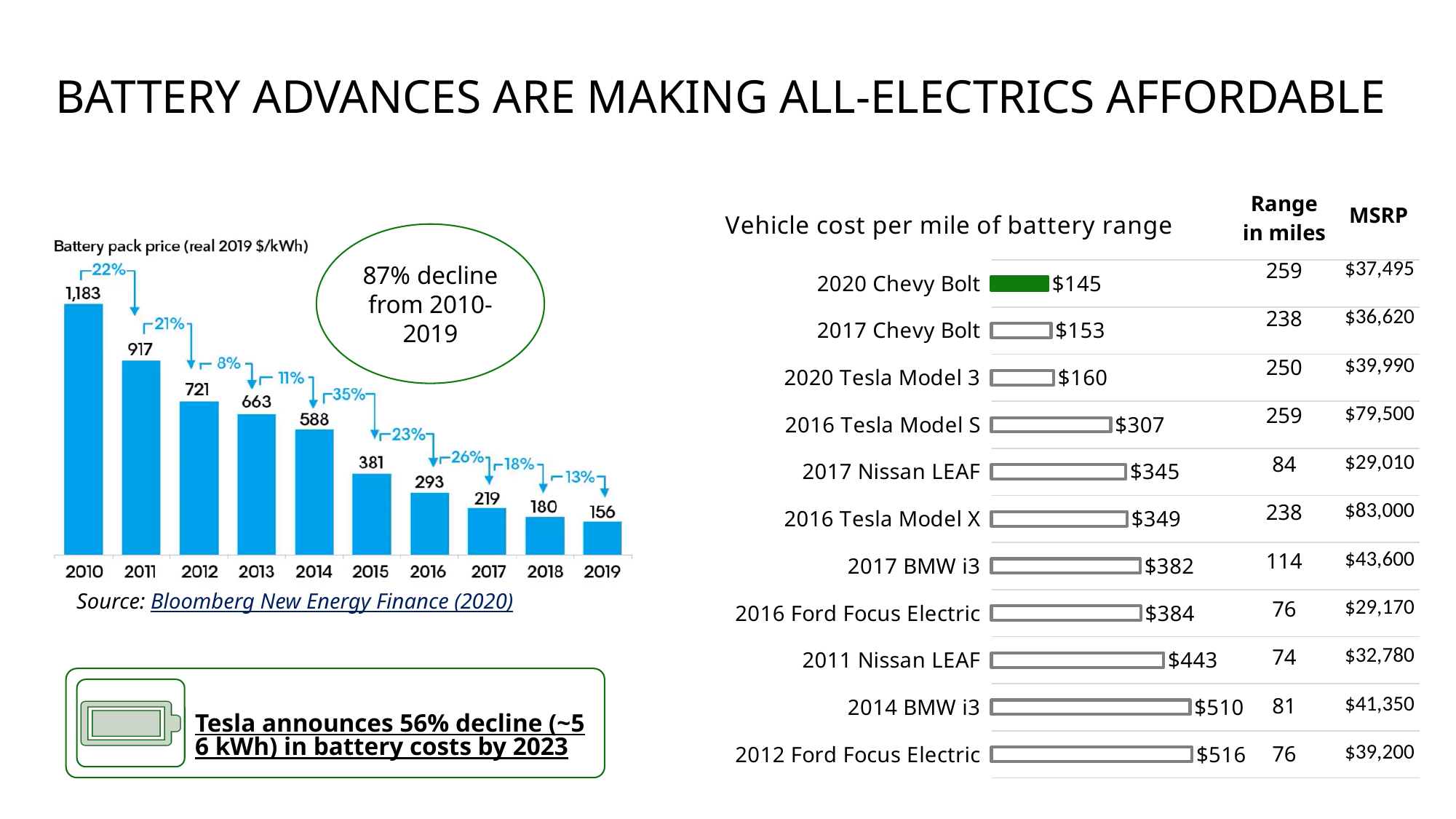
In the 'Battery pack price (real 2019 $/kWh)' chart, what percentage change is labelled between 2014 and 2015? -35% In the 'Vehicle cost per mile of battery range' chart, what is the difference between the 2011 Nissan LEAF and the 2017 Nissan LEAF? $98 What kind of chart is the 'Vehicle cost per mile of battery range' chart? bar chart In the 'Vehicle cost per mile of battery range' chart, what is the value for the 2020 Chevy Bolt? $145 In the 'Battery pack price (real 2019 $/kWh)' chart, what is the difference between the 2014 and 2015 values? 207 In the 'Battery pack price (real 2019 $/kWh)' chart, what is the value for 2010? 1,183 In the 'Vehicle cost per mile of battery range' chart, which vehicle has the highest value? 2012 Ford Focus Electric In the 'Battery pack price (real 2019 $/kWh)' chart, do the values rise or fall from 2010 to 2019? fall In the 'Vehicle cost per mile of battery range' chart, which is larger, the value for the 2016 Tesla Model S or the 2017 BMW i3? 2017 BMW i3 In the 'Battery pack price (real 2019 $/kWh)' chart, what is the value for 2015? 381 In the 'Battery pack price (real 2019 $/kWh)' chart, how many years are shown? 10 In the 'Battery pack price (real 2019 $/kWh)' chart, which year has the lowest value? 2019